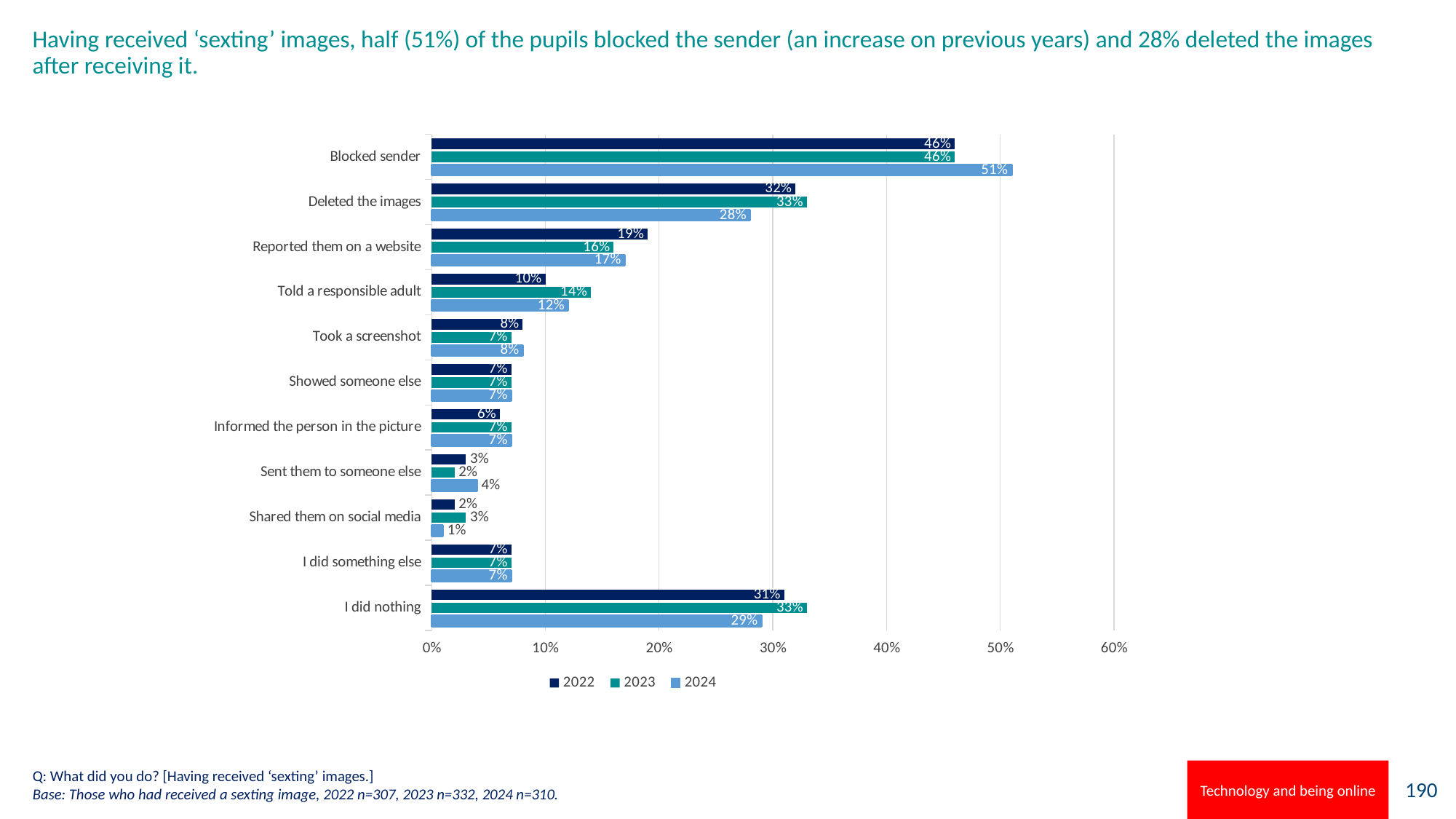
Which is larger for 'Reported them on a website': the 2022 value or the 2023 value? 2022 What percentage of pupils told a responsible adult in 2022? 10% What kind of chart is shown on the slide? Bar chart Which category has the lowest value for 2024? Shared them on social media Which category has the highest value for 2024? Blocked sender How many series does the legend list? 3 What is the difference between the 2024 and 2023 values for 'Blocked sender'? 5 percentage points Which year does the lightest blue bar represent according to the legend? 2024 What percentage of pupils deleted the images in 2023? 33% How many categories are shown on the chart? 11 What percentage of pupils blocked the sender in 2024? 51% What is the difference between the 2023 and 2024 values for 'I did nothing'? 4 percentage points